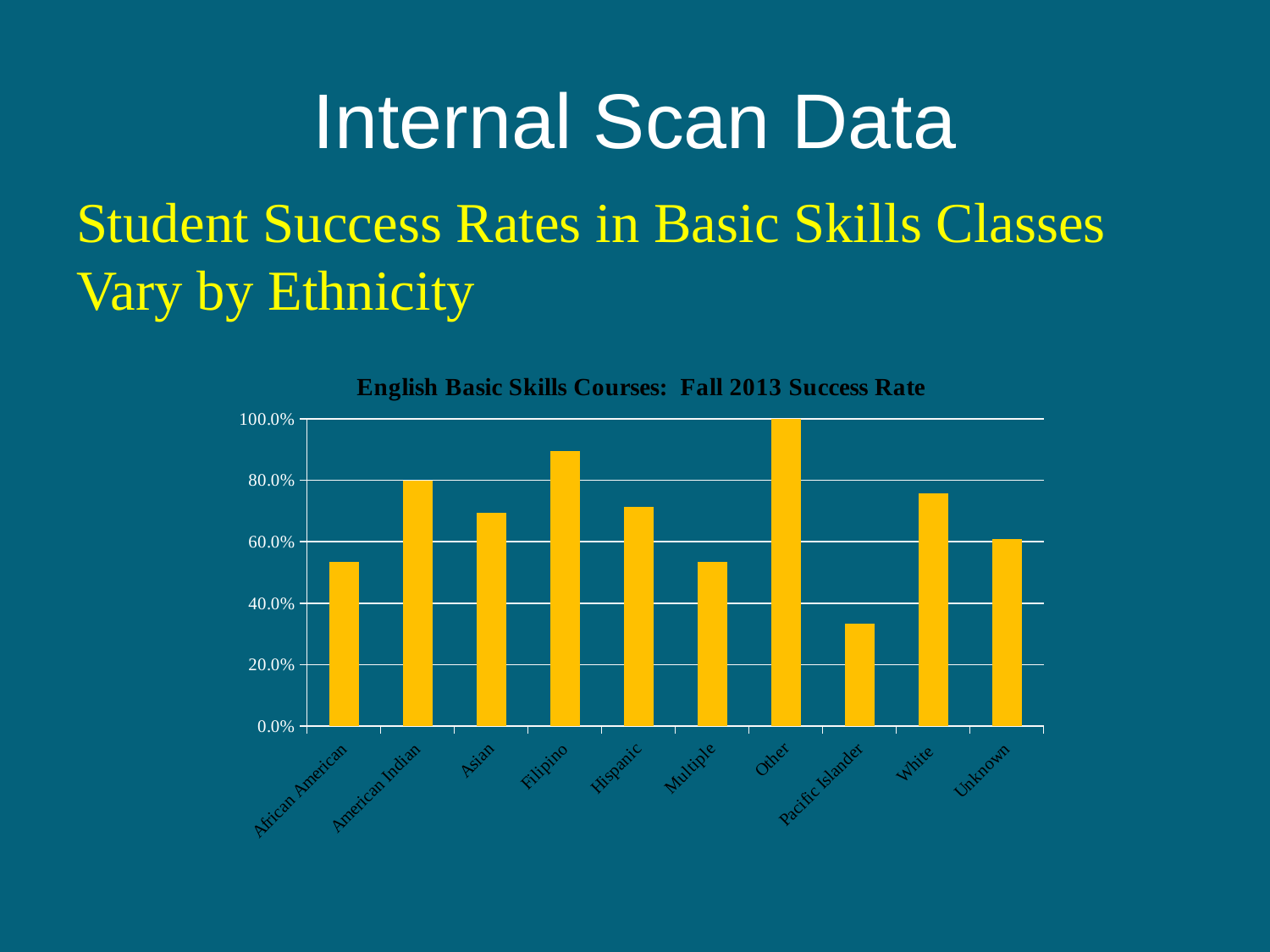
Which has a higher success rate, White or Multiple? White Is the success rate for Filipino greater or less than 80.0%? greater Which category has the highest success rate in the chart? Other Which category has the lowest success rate in the chart? Pacific Islander What is the title of the chart? English Basic Skills Courses: Fall 2013 Success Rate Is the success rate for White greater or less than 80.0%? less Is the success rate for Pacific Islander greater or less than 40.0%? less What type of chart is shown on the slide? Bar chart What is the success rate for the Other category? 100.0% Which has a higher success rate, Filipino or Hispanic? Filipino How many ethnicity categories are shown on the x axis of the chart? 10